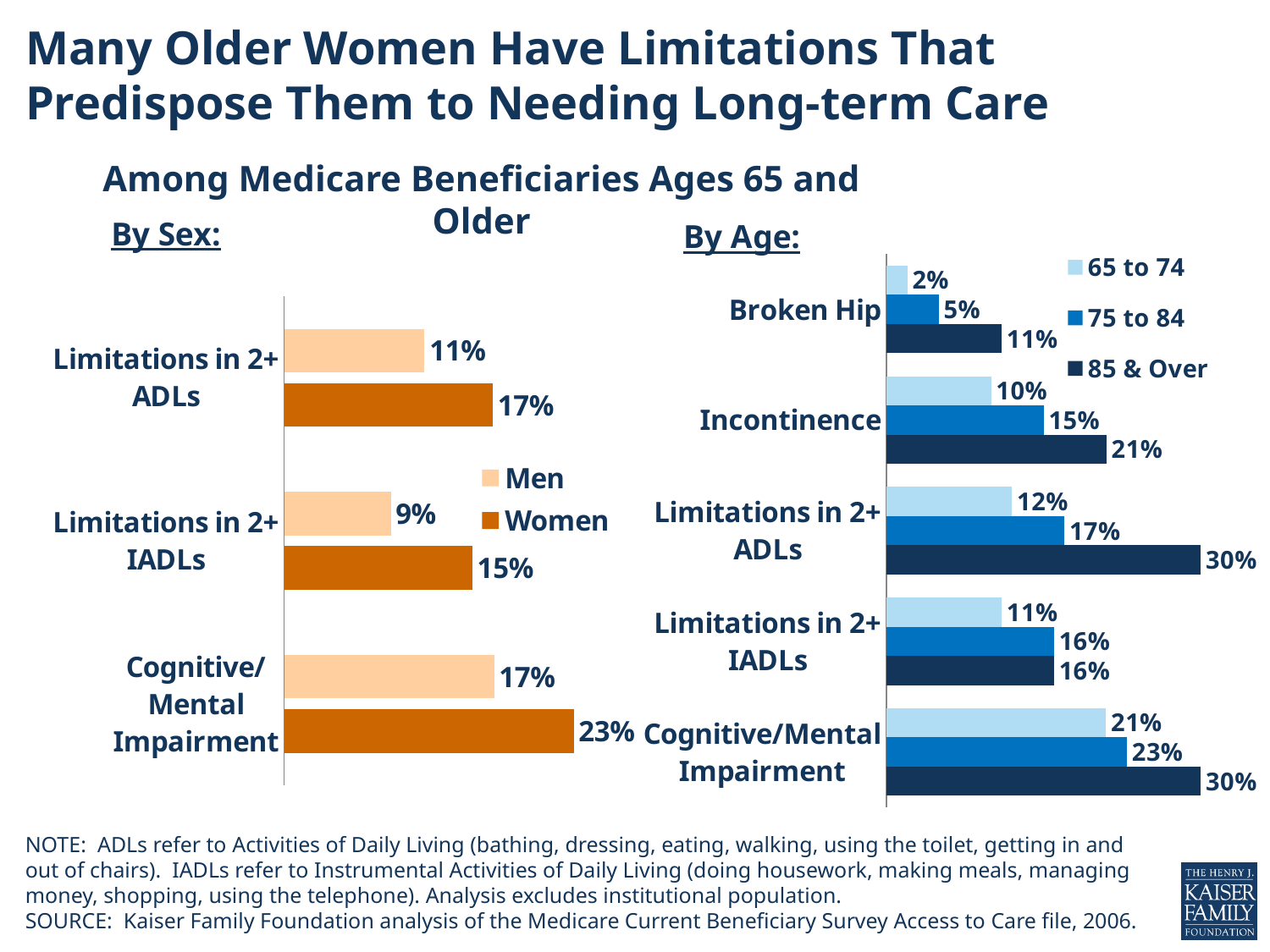
In the 'By Age' chart, how many categories are shown? 5 In the 'By Sex' chart, what is the value for Men with Cognitive/Mental Impairment? 17% In the 'By Sex' chart, what is the difference between Women and Men for Limitations in 2+ IADLs? 6% In the 'By Sex' chart, which category has the highest value for Women? Cognitive/Mental Impairment In the 'By Sex' chart, how many series does the legend list? 2 In the 'By Age' chart, what is the value for 85 & Over with Incontinence? 21% In the 'By Sex' chart, what is the value for Women with Limitations in 2+ ADLs? 17% In the 'By Age' chart, what is the value for 65 to 74 with Broken Hip? 2% What type of chart is the 'By Age' chart? Bar chart In the 'By Age' chart, which category has the lowest value for 75 to 84? Broken Hip In the 'By Age' chart, which is larger for Cognitive/Mental Impairment: 65 to 74 or 75 to 84? 75 to 84 In the 'By Age' chart, what is the difference between 85 & Over and 65 to 74 for Limitations in 2+ ADLs? 18%